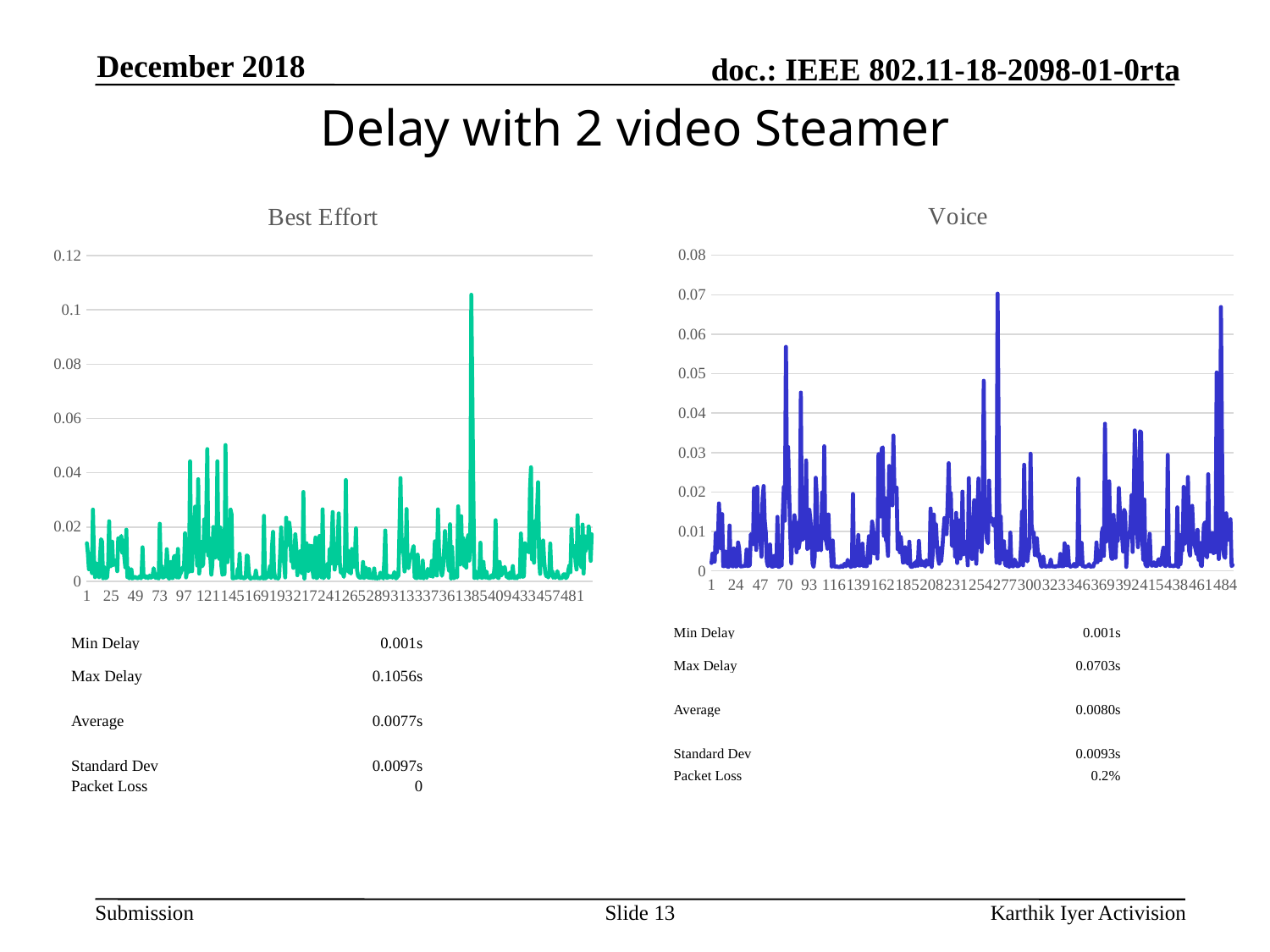
What is the maximum value shown on the y axis of the Voice chart? 0.08 In the Best Effort chart, is the highest peak greater or less than 0.12? less What is the title of the chart on the right side of the slide? Voice What is the title of the chart on the left side of the slide? Best Effort In the Voice chart, is the highest peak greater or less than 0.06? greater What kind of chart is the Voice chart? line chart Which chart reaches a higher peak delay, Best Effort or Voice? Best Effort What kind of chart is the Best Effort chart? line chart In the Voice chart, is the highest peak greater or less than 0.08? less